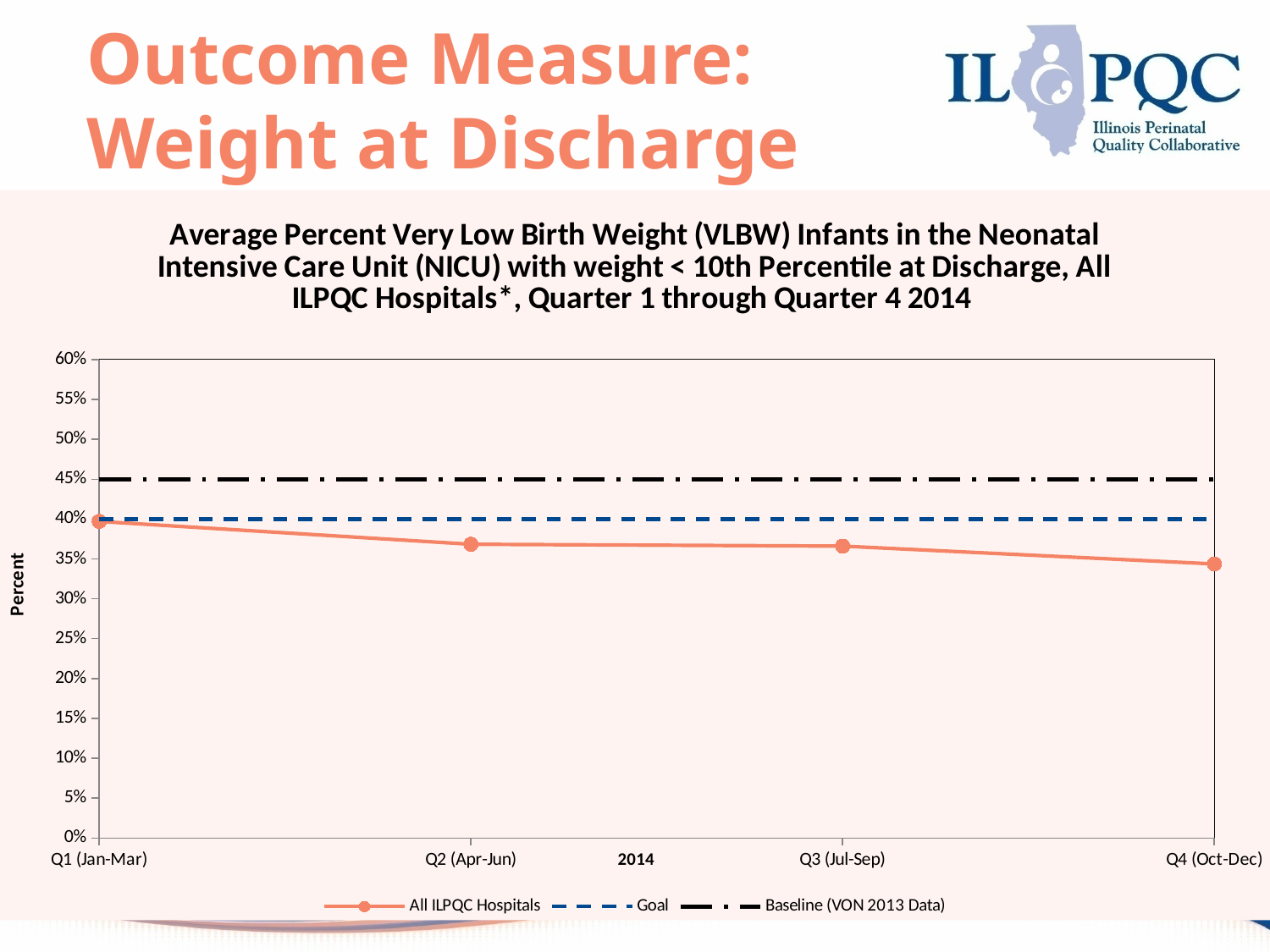
Is the All ILPQC Hospitals value for Q1 (Jan-Mar) greater or less than 35%? greater How many series does the legend list? 3 What is the label of the y axis? Percent Do the All ILPQC Hospitals values rise or fall from Q1 to Q4? fall Is the All ILPQC Hospitals value for Q2 (Apr-Jun) greater or less than 40%? less How many quarters are plotted on the x axis? 4 Which is larger, the All ILPQC Hospitals value for Q1 (Jan-Mar) or for Q4 (Oct-Dec)? Q1 (Jan-Mar) Is the All ILPQC Hospitals value for Q3 (Jul-Sep) greater or less than 35%? greater What kind of chart is shown on the slide? line chart Which quarter has the highest value for All ILPQC Hospitals? Q1 (Jan-Mar) At what percent is the Goal line drawn? 40% Which quarter has the lowest value for All ILPQC Hospitals? Q4 (Oct-Dec)